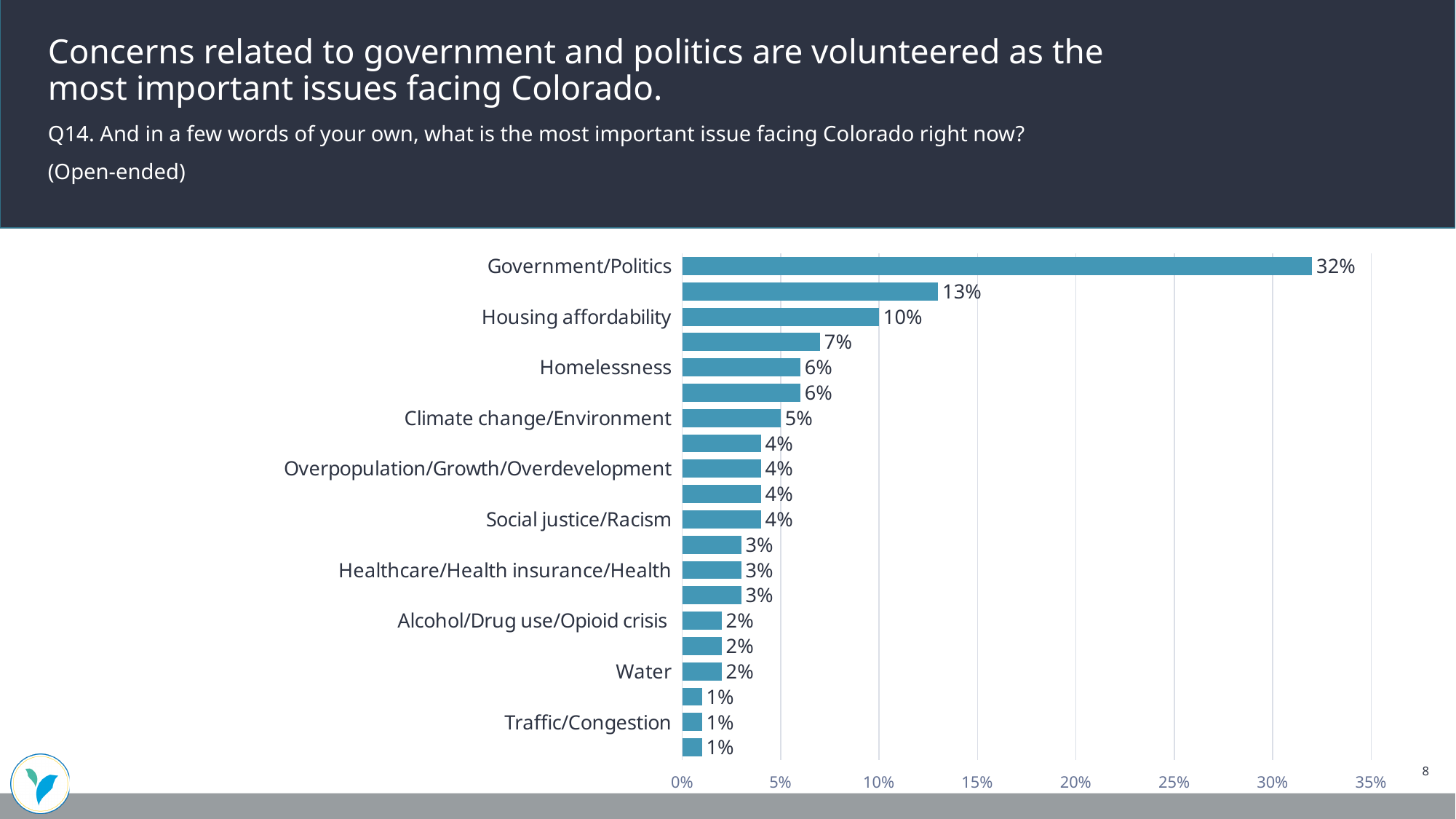
Which is larger, the value for Homelessness or the value for Water? Homelessness How many bars are plotted on the chart? 20 What is the difference between the values for Government/Politics and Housing affordability? 22% What is the value shown for Homelessness? 6% What percentage of respondents named Government/Politics as the most important issue facing Colorado? 32% What is the value shown for Climate change/Environment? 5% Is the value for Government/Politics greater or less than 30%? greater Which labeled category has the highest value on the chart? Government/Politics What is the value shown for Healthcare/Health insurance/Health? 3% What is the value shown for Traffic/Congestion? 1% What is the value shown for Housing affordability? 10% What kind of chart is shown on the slide? Bar chart